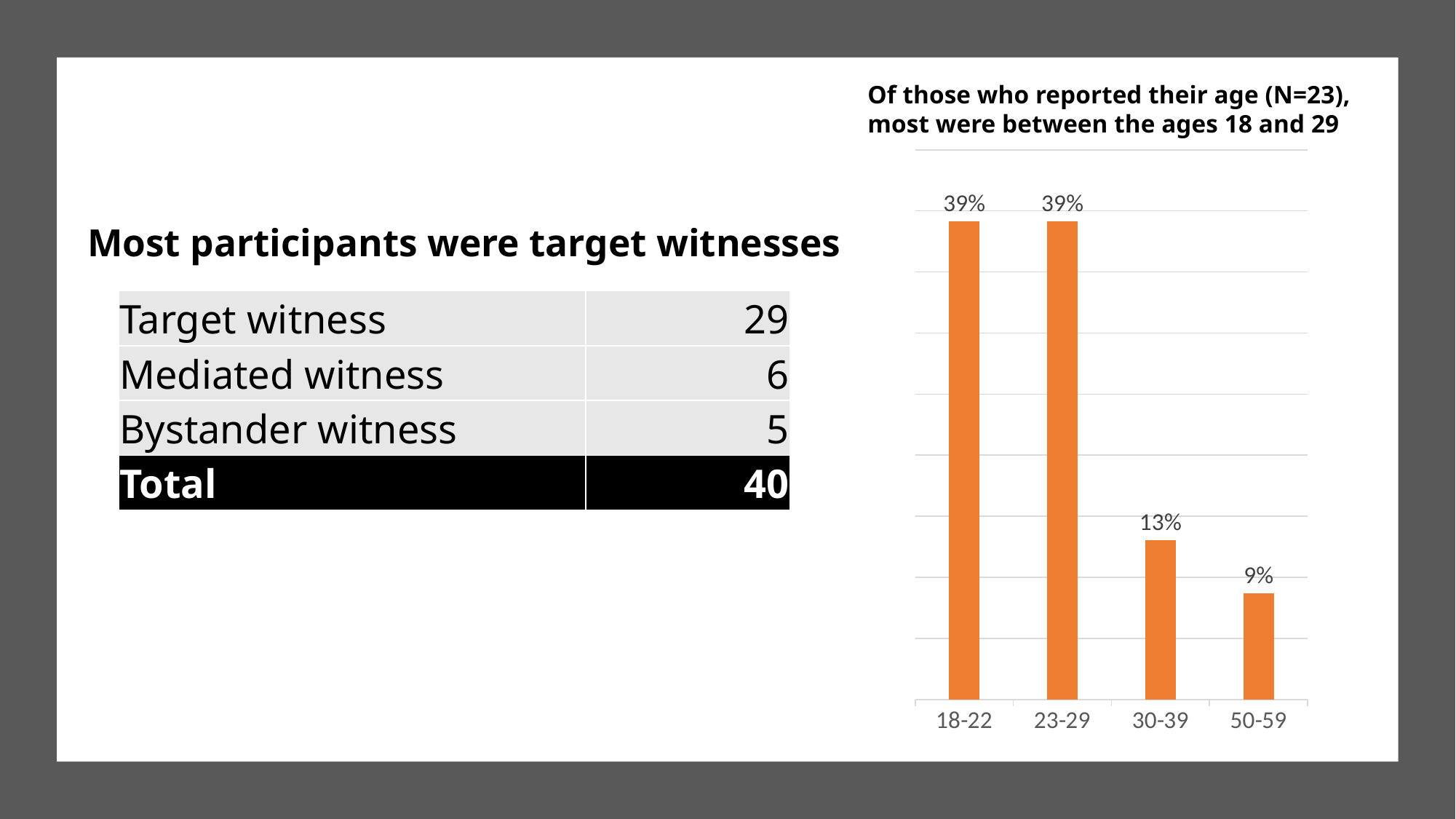
What colour are the bars in the chart? Orange What is the difference between the values for 23-29 and 30-39? 26% Do the values rise or fall from left to right across the age groups? Fall What is the value for the 30-39 age group? 13% What kind of chart is shown on the slide? Bar chart What is the difference between the values for 30-39 and 50-59? 4% How many age groups are shown on the chart? 4 Which is larger, the value for 30-39 or the value for 50-59? 30-39 What is the value for the 50-59 age group? 9% What is the value for the 23-29 age group? 39% Which age group has the lowest value? 50-59 What is the value for the 18-22 age group? 39%